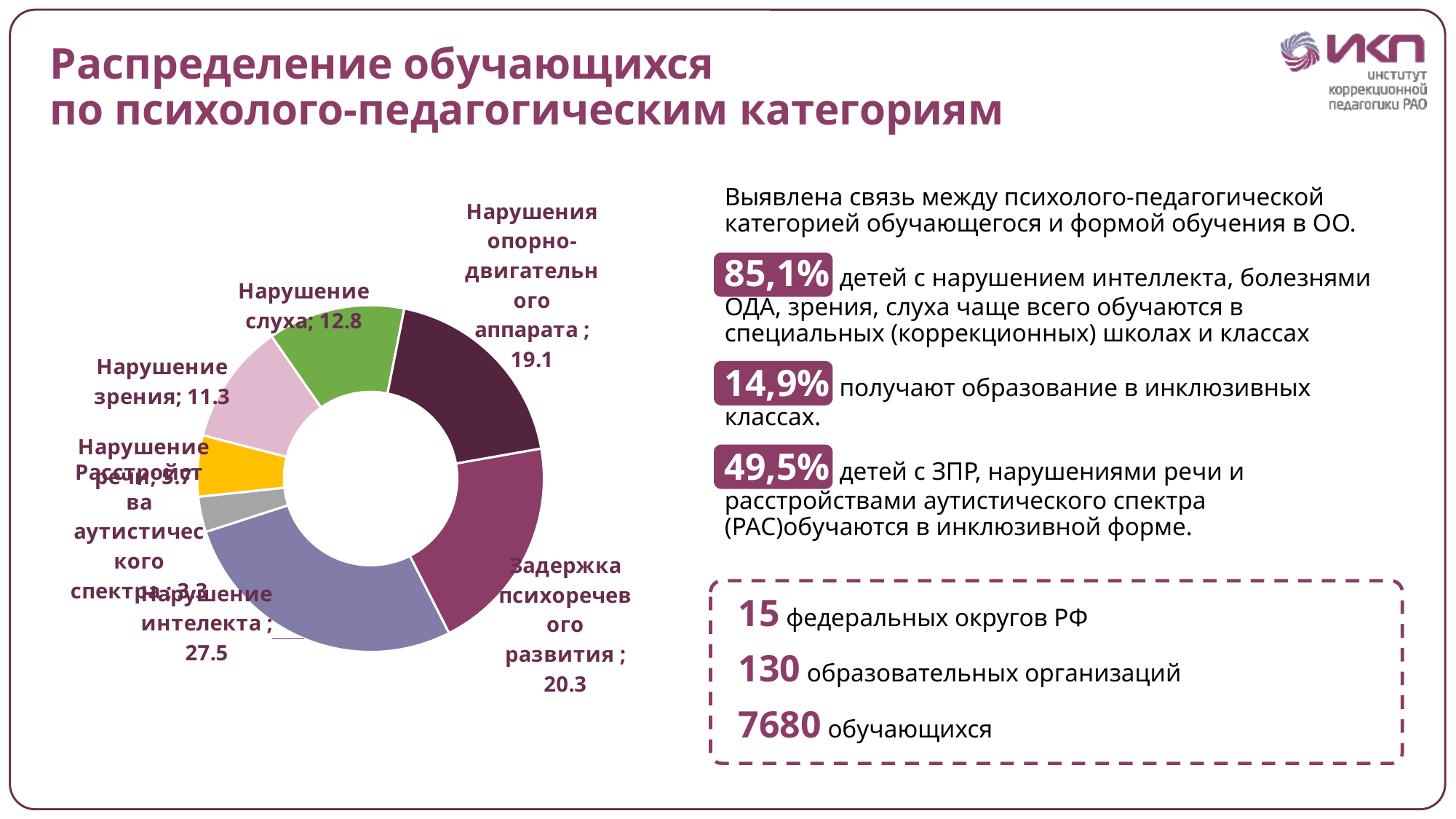
What is the value for Задержка психоречевого развития in the chart? 20.3 Which is larger: the value for Задержка психоречевого развития or for Нарушения опорно-двигательного аппарата? Задержка психоречевого развития What is the value for Нарушение интелекта in the chart? 27.5 What kind of chart is shown on the slide? Doughnut (pie) chart How many categories are shown in the chart? 7 What is the difference between the values for Нарушение интелекта and Задержка психоречевого развития? 7.2 Which category has the largest share in the chart? Нарушение интелекта What is the difference between the values for Нарушение слуха and Нарушение зрения? 1.5 What is the value for Нарушение зрения in the chart? 11.3 Which category has the smallest share in the chart? Расстройства аутистического спектра What is the value for Нарушения опорно-двигательного аппарата in the chart? 19.1 What is the value for Нарушение слуха in the chart? 12.8